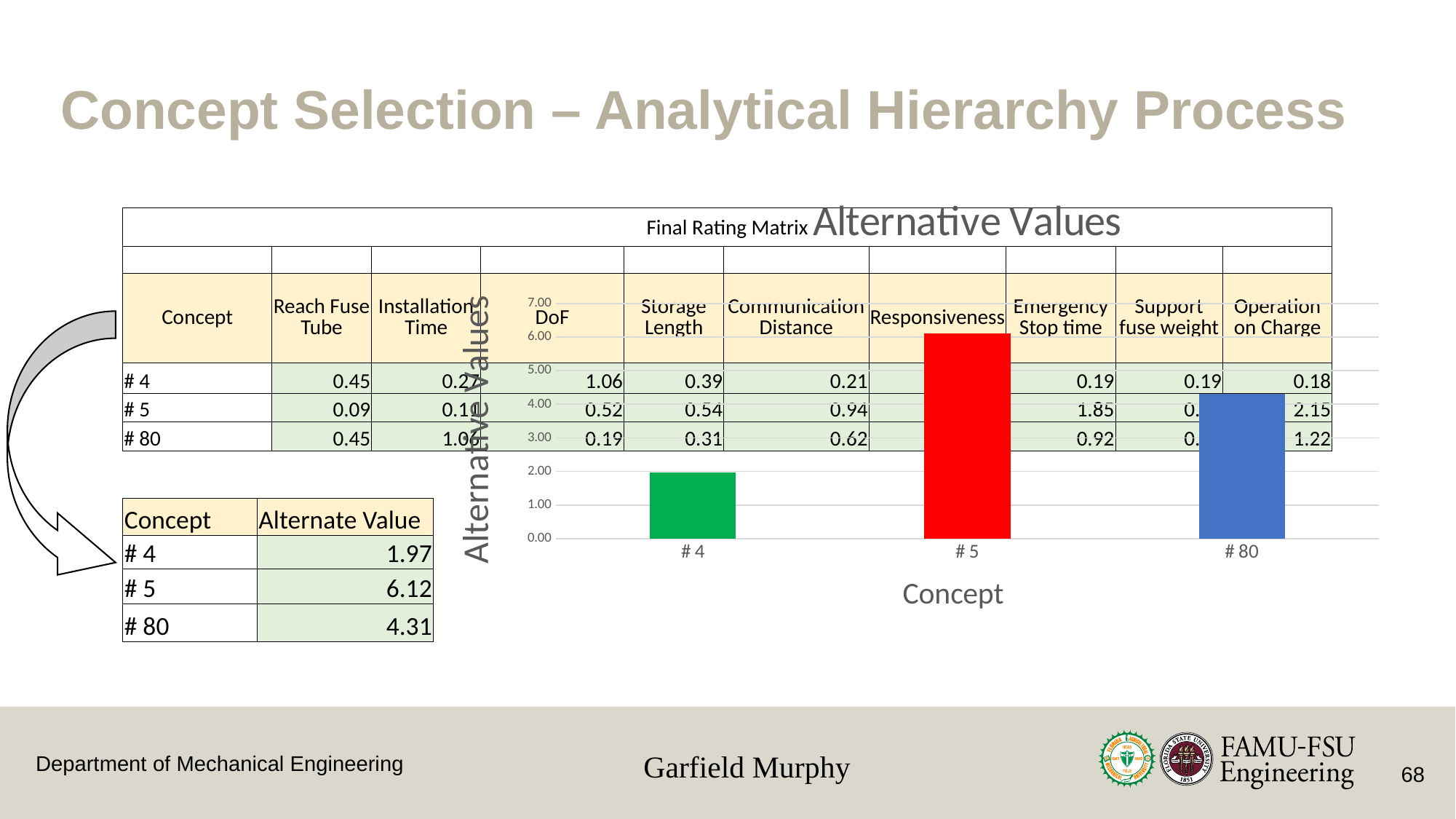
Is the bar for # 80 greater or less than 5.00? less Which has a larger bar in the chart, # 80 or # 4? # 80 Is the bar for # 5 greater or less than 5.00? greater Is the bar for # 80 greater or less than 4.00? greater Which concept has the highest bar in the Alternative Values chart? # 5 What kind of chart is shown on the slide? bar chart What is the title of the chart's horizontal axis? Concept What colour is the bar for # 5 in the chart? red How many concepts are plotted in the Alternative Values chart? 3 Which concept has the lowest bar in the Alternative Values chart? # 4